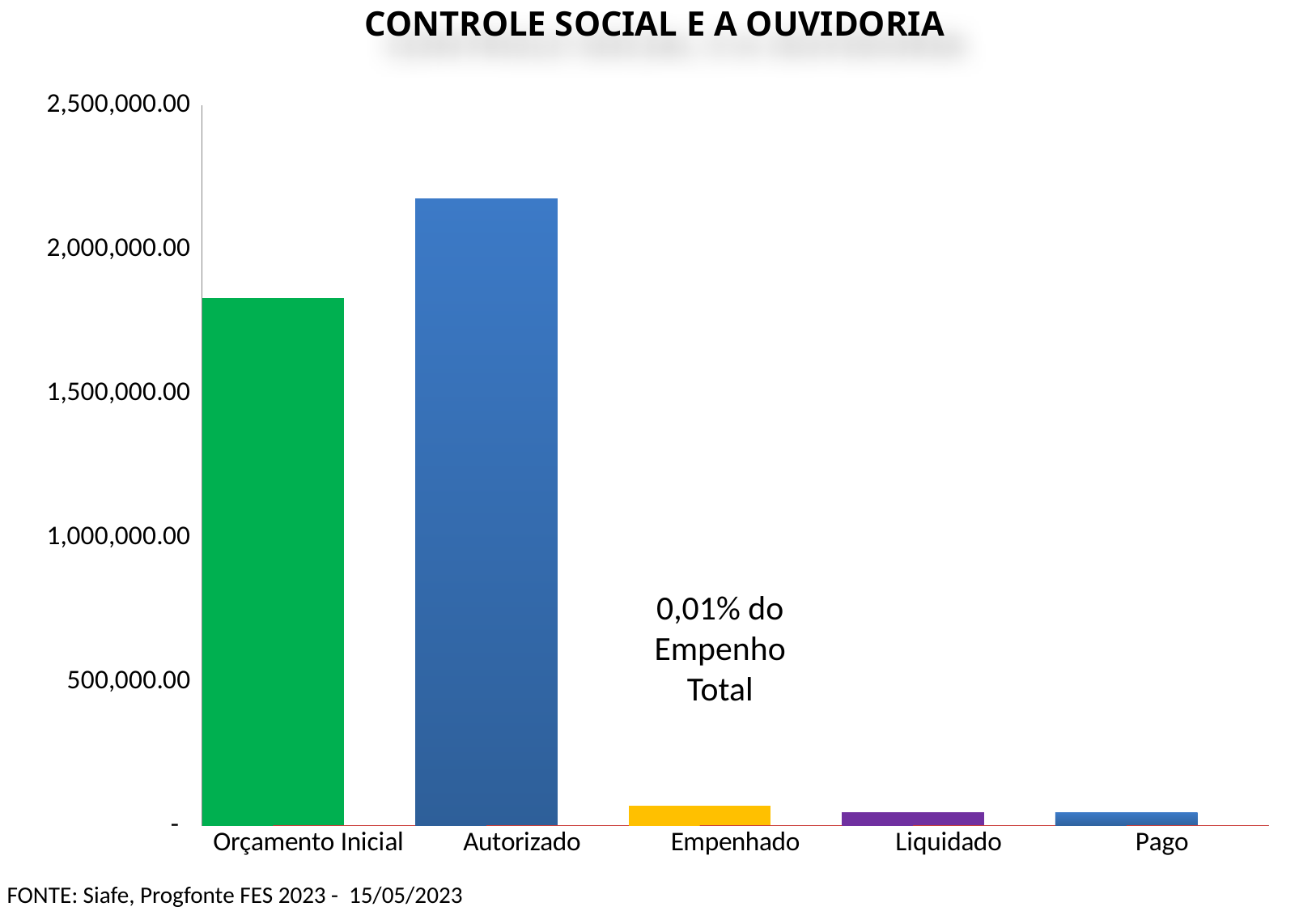
Which is larger, the value for Orçamento Inicial or the value for Autorizado? Autorizado What kind of chart is shown on the slide? bar chart What is the title of the chart? CONTROLE SOCIAL E A OUVIDORIA Is the value for Orçamento Inicial greater or less than 2,000,000.00? less Is the value for Empenhado greater or less than 500,000.00? less Do the values rise or fall from Autorizado to Pago along the x axis? fall Which is larger, the value for Empenhado or the value for Liquidado? Empenhado Which category has the highest value in the chart? Autorizado What text annotation is printed above the Empenhado bar? 0,01% do Empenho Total Is the value for Orçamento Inicial greater or less than 1,500,000.00? greater How many categories are shown on the x axis of the chart? 5